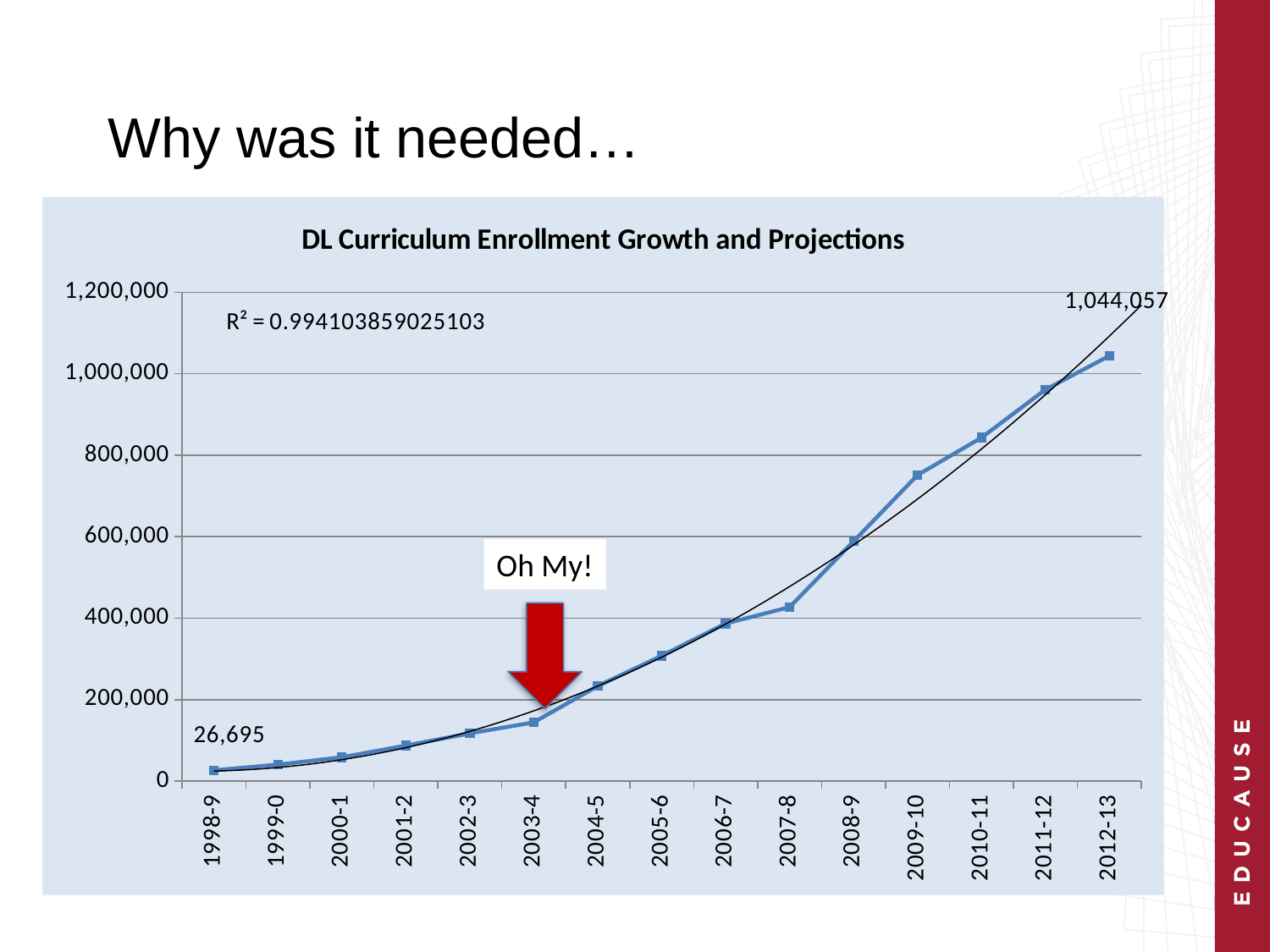
Which year has the highest enrollment value? 2012-13 How many years are shown on the x axis? 15 Which year has the lowest enrollment value? 1998-9 Which is larger, the value for 2008-9 or the value for 2006-7? 2008-9 What kind of chart is shown on the slide? line chart What is the title of the chart? DL Curriculum Enrollment Growth and Projections Is the value for 2009-10 greater or less than 600,000? greater What is the enrollment value for 1998-9? 26,695 Is the value for 2007-8 greater or less than 600,000? less What is the enrollment value for 2012-13? 1,044,057 Do the enrollment values rise or fall from 1998-9 to 2012-13? rise What is the difference between the 2012-13 value and the 1998-9 value? 1,017,362